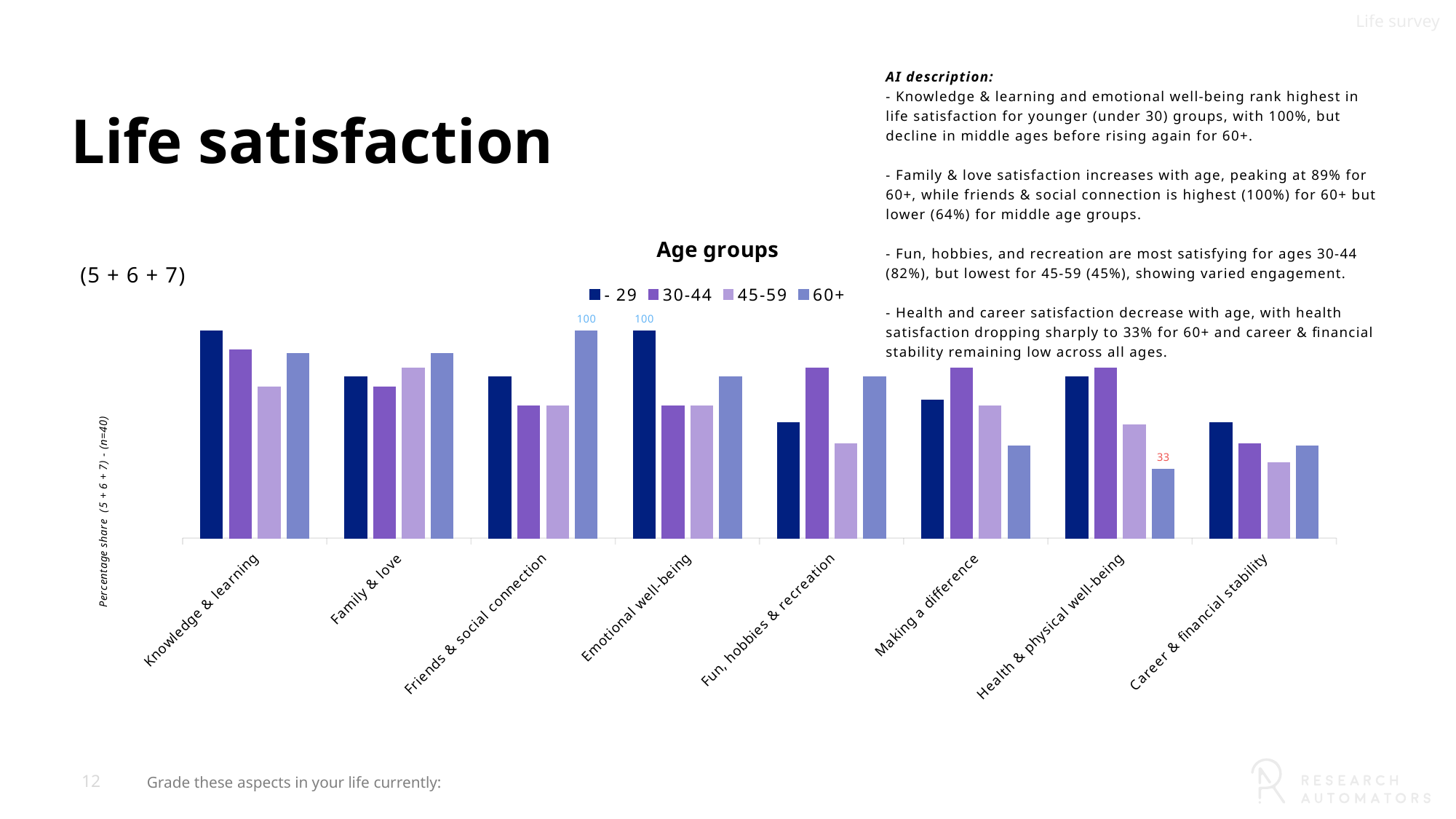
Which age group has the highest bar in the Making a difference category? 30-44 What kind of chart is shown on the slide? Bar chart What is the value for the 60+ age group in the Friends & social connection category? 100 What is the value for the 60+ age group in the Health & physical well-being category? 33 What is the value for the - 29 age group in the Emotional well-being category? 100 Which age group has the lowest bar in the Fun, hobbies & recreation category? 45-59 What is the difference between the 60+ value for Friends & social connection and the 60+ value for Health & physical well-being? 67 How many age groups does the legend list? 4 How many categories are shown on the x axis of the chart? 8 Which age group has the lowest bar in the Health & physical well-being category? 60+ In the Fun, hobbies & recreation category, which is larger: the - 29 bar or the 30-44 bar? 30-44 Which age group has the highest bar in the Fun, hobbies & recreation category? 30-44